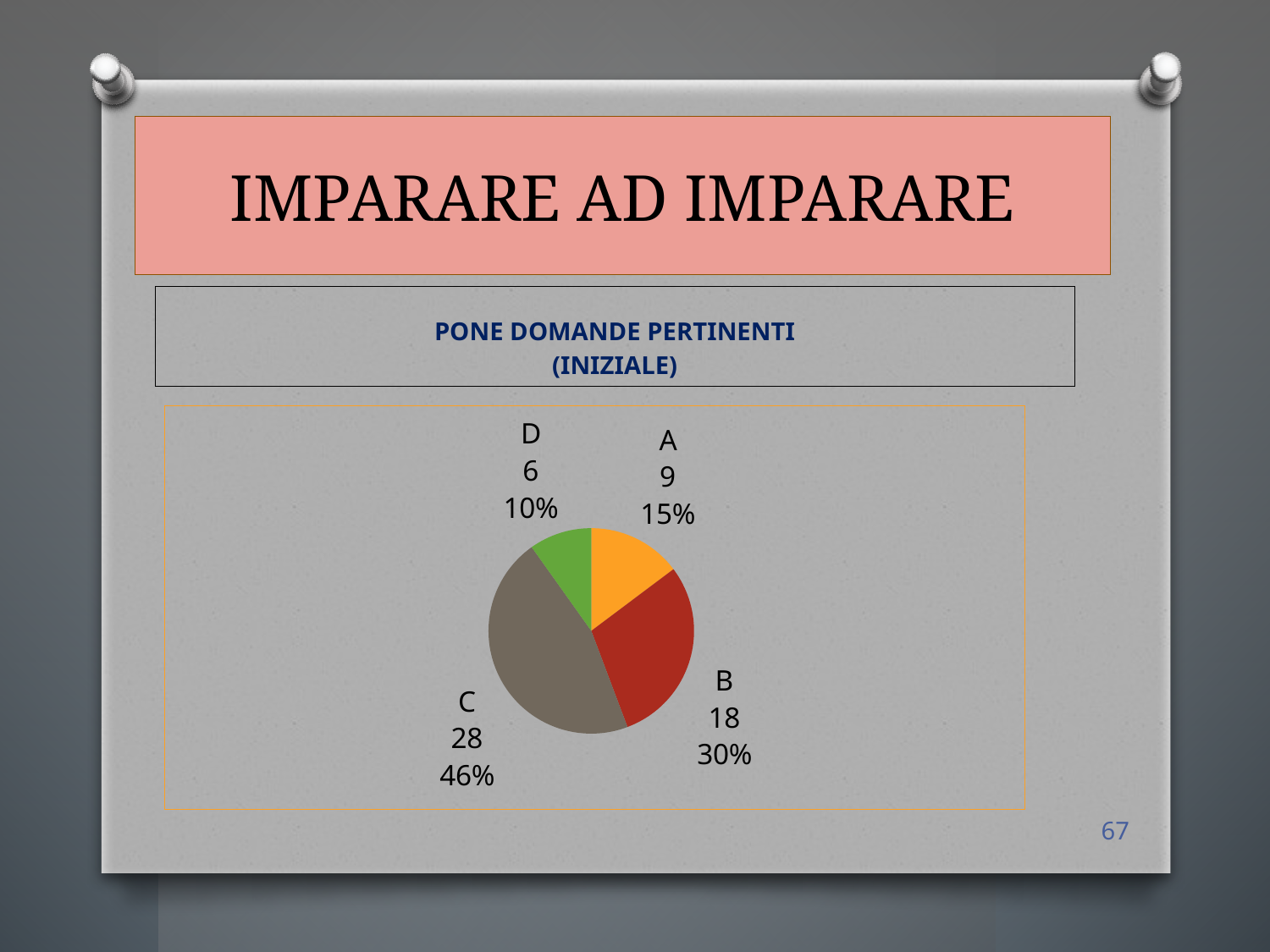
What percentage share does category B have? 30% Which category has the smallest slice? D Which is larger, the value for A or the value for D? A What kind of chart is shown on the slide? pie chart What is the value for category C? 28 What percentage share does category D have? 10% Which category has the largest slice? C What is the total of all four category values? 61 What is the title shown above the chart? PONE DOMANDE PERTINENTI (INIZIALE) What is the difference between the values for C and B? 10 What is the value for category A? 9 How many categories are shown in the pie chart? 4